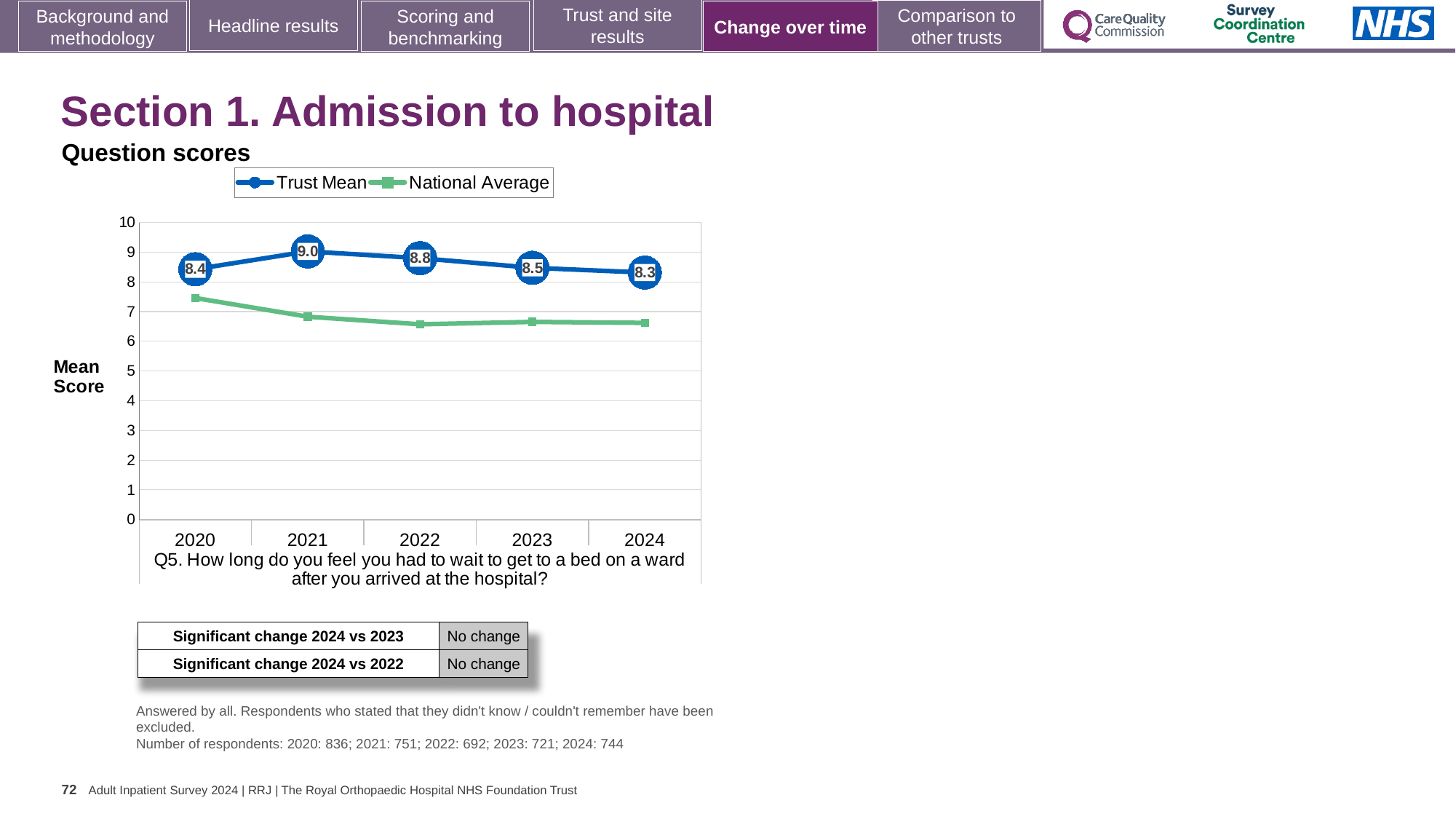
Is the National Average for 2020 greater or less than 7? greater In which year is the Trust Mean lowest? 2024 How many series does the legend list? 2 Is the National Average for 2022 greater or less than 7? less How many years are plotted on the x axis? 5 What is the difference between the Trust Mean in 2021 and in 2024? 0.7 Which is larger, the Trust Mean in 2022 or in 2023? 2022 What kind of chart is shown? Line chart What is the Trust Mean score for 2024? 8.3 In which year is the Trust Mean highest? 2021 What is the Trust Mean score for 2020? 8.4 What is the Trust Mean score for 2021? 9.0